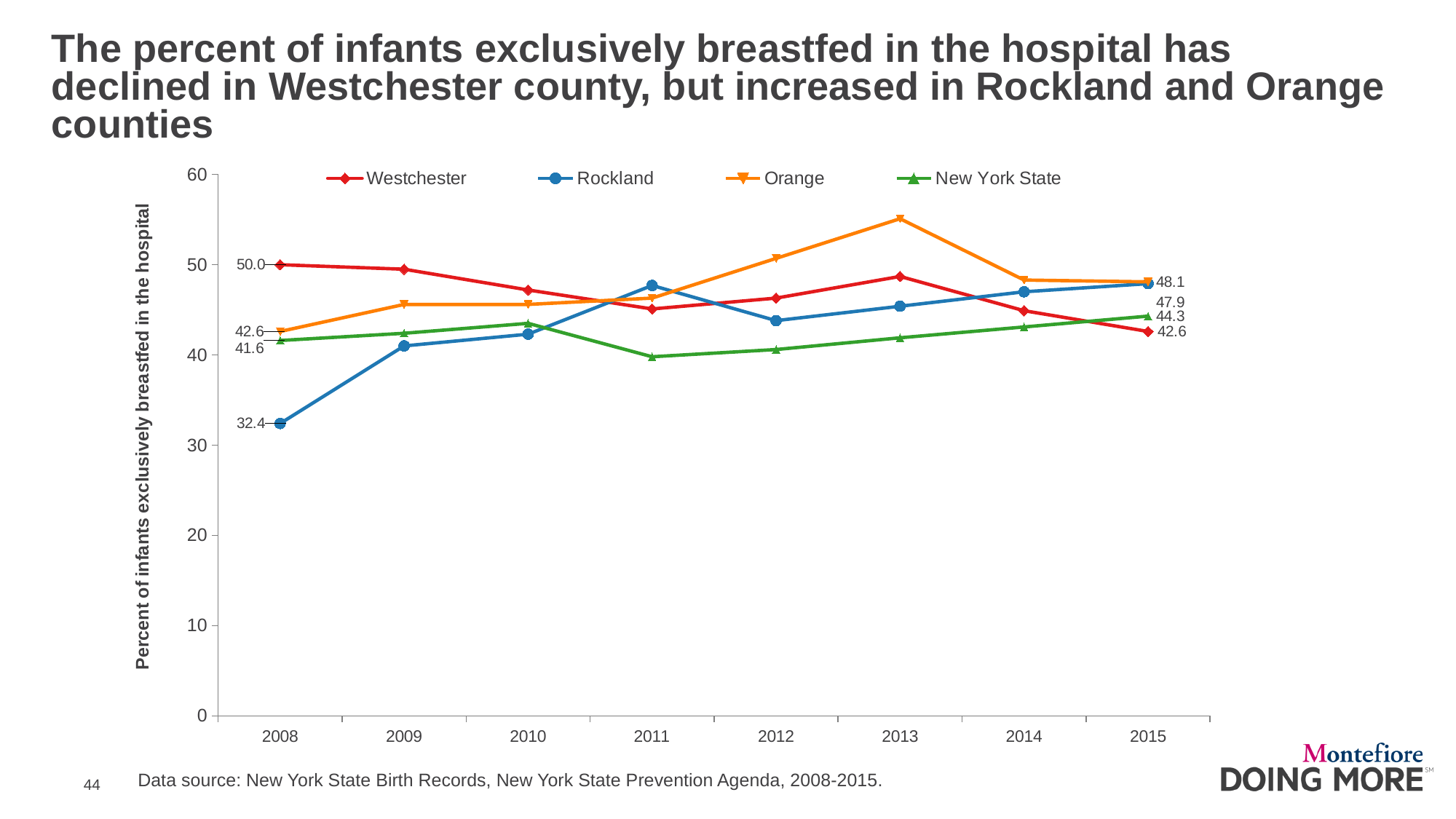
Which series had the lowest value in 2008? Rockland What was the value for Westchester in 2015? 42.6 What kind of chart is shown on the slide? Line chart Is the value for Orange in 2013 greater or less than 50? greater What was the value for New York State in 2015? 44.3 What was the value for Orange in 2008? 42.6 Which series had the highest value in 2013? Orange How many series does the legend list? 4 What was the value for Rockland in 2008? 32.4 What was the percent of infants exclusively breastfed in Westchester in 2008? 50.0 How many years are shown on the x axis? 8 By how much did the Westchester value decline from 2008 to 2015? 7.4